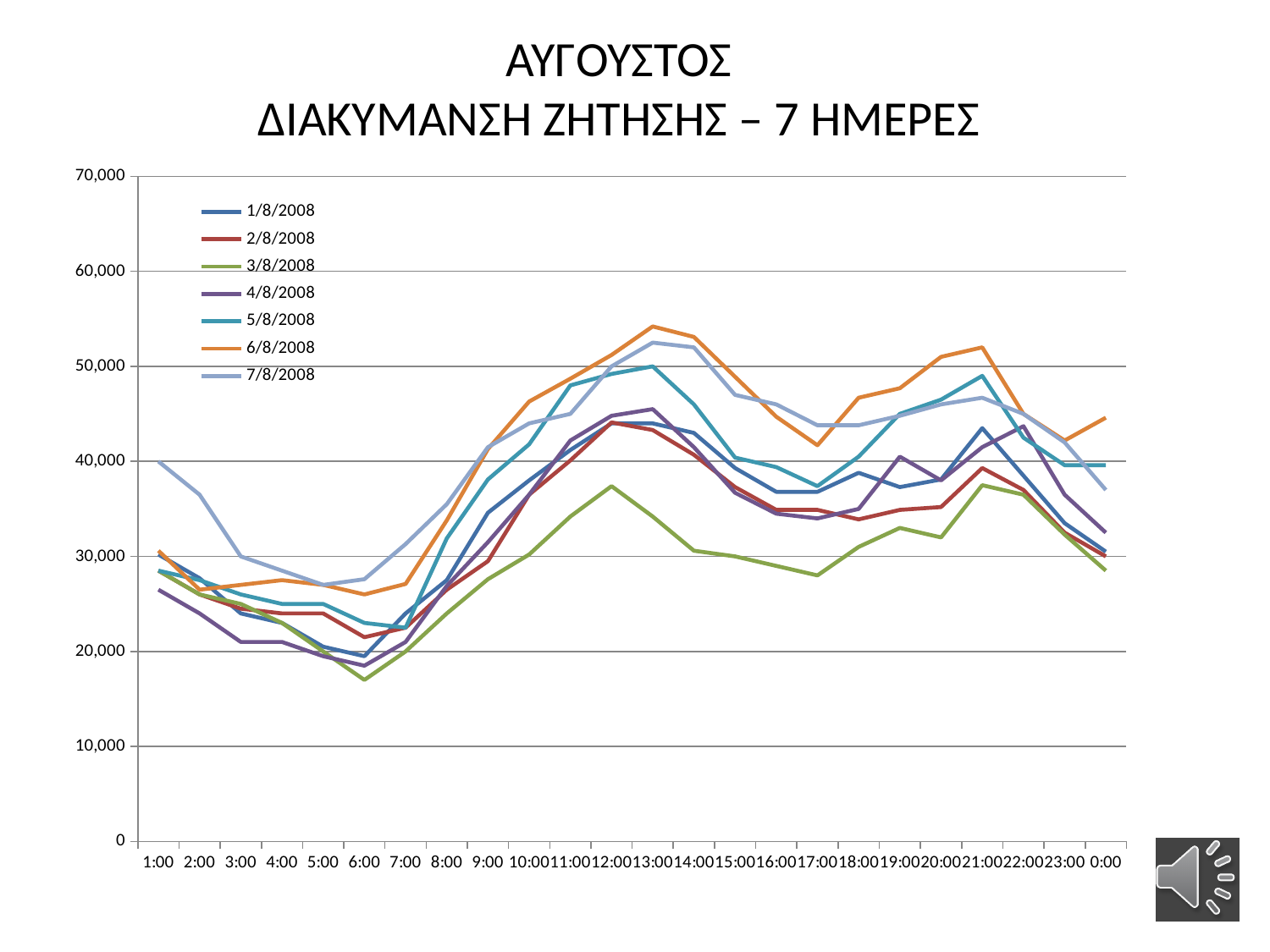
What kind of chart is shown on the slide? line chart Is the value for 1/8/2008 at 21:00 greater or less than 40,000? greater Is the value for 3/8/2008 at 6:00 greater or less than 20,000? less How many series does the legend list? 7 Is the value for 3/8/2008 at 12:00 greater or less than 40,000? less How many time points are shown along the x axis? 24 At 6:00, which series has the larger value, 7/8/2008 or 3/8/2008? 7/8/2008 Which series has the lowest value at 12:00? 3/8/2008 Does the 3/8/2008 series rise or fall between 6:00 and 12:00? rise Which series has the highest value at 1:00? 7/8/2008 Which series has the highest value at 13:00? 6/8/2008